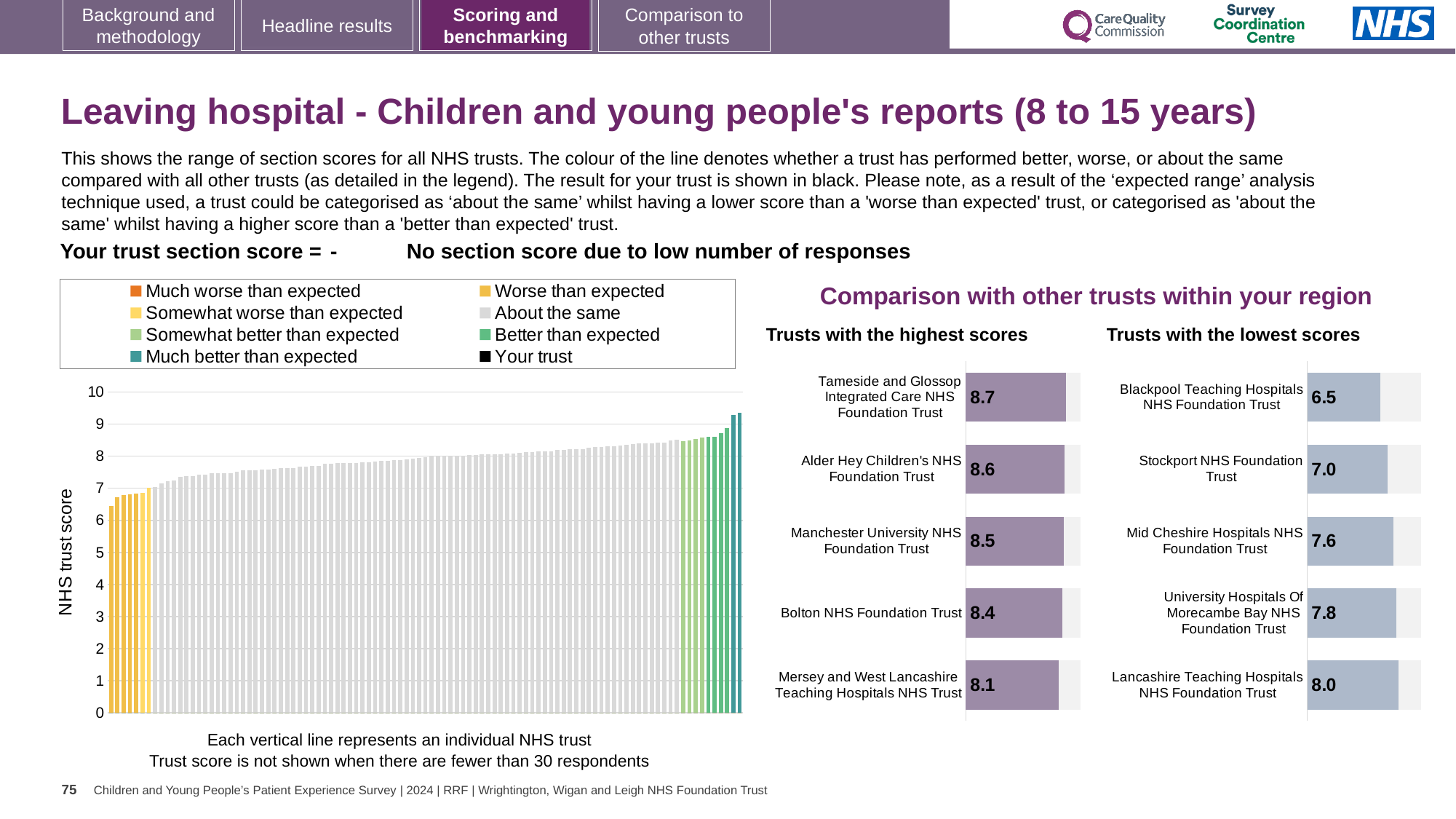
How many trusts are listed in the 'Trusts with the highest scores' chart? 5 In the 'Trusts with the highest scores' chart, what is the score for Tameside and Glossop Integrated Care NHS Foundation Trust? 8.7 How many entries does the legend of the left-hand chart of all NHS trusts list? 8 In the 'Trusts with the lowest scores' chart, what is the score for Blackpool Teaching Hospitals NHS Foundation Trust? 6.5 Which has the higher score: Bolton NHS Foundation Trust in the 'Trusts with the highest scores' chart or Stockport NHS Foundation Trust in the 'Trusts with the lowest scores' chart? Bolton NHS Foundation Trust In the 'Trusts with the highest scores' chart, which trust has the highest score? Tameside and Glossop Integrated Care NHS Foundation Trust What is the y-axis label of the left-hand chart showing all NHS trusts? NHS trust score What kind of chart is the 'Trusts with the lowest scores' chart? Bar chart In the 'Trusts with the lowest scores' chart, which trust has the lowest score? Blackpool Teaching Hospitals NHS Foundation Trust In the 'Trusts with the highest scores' chart, what is the difference between the scores of Tameside and Glossop Integrated Care NHS Foundation Trust and Mersey and West Lancashire Teaching Hospitals NHS Trust? 0.6 In the 'Trusts with the lowest scores' chart, what is the score for Stockport NHS Foundation Trust? 7.0 In the 'Trusts with the lowest scores' chart, what is the difference between the scores of Lancashire Teaching Hospitals NHS Foundation Trust and Blackpool Teaching Hospitals NHS Foundation Trust? 1.5